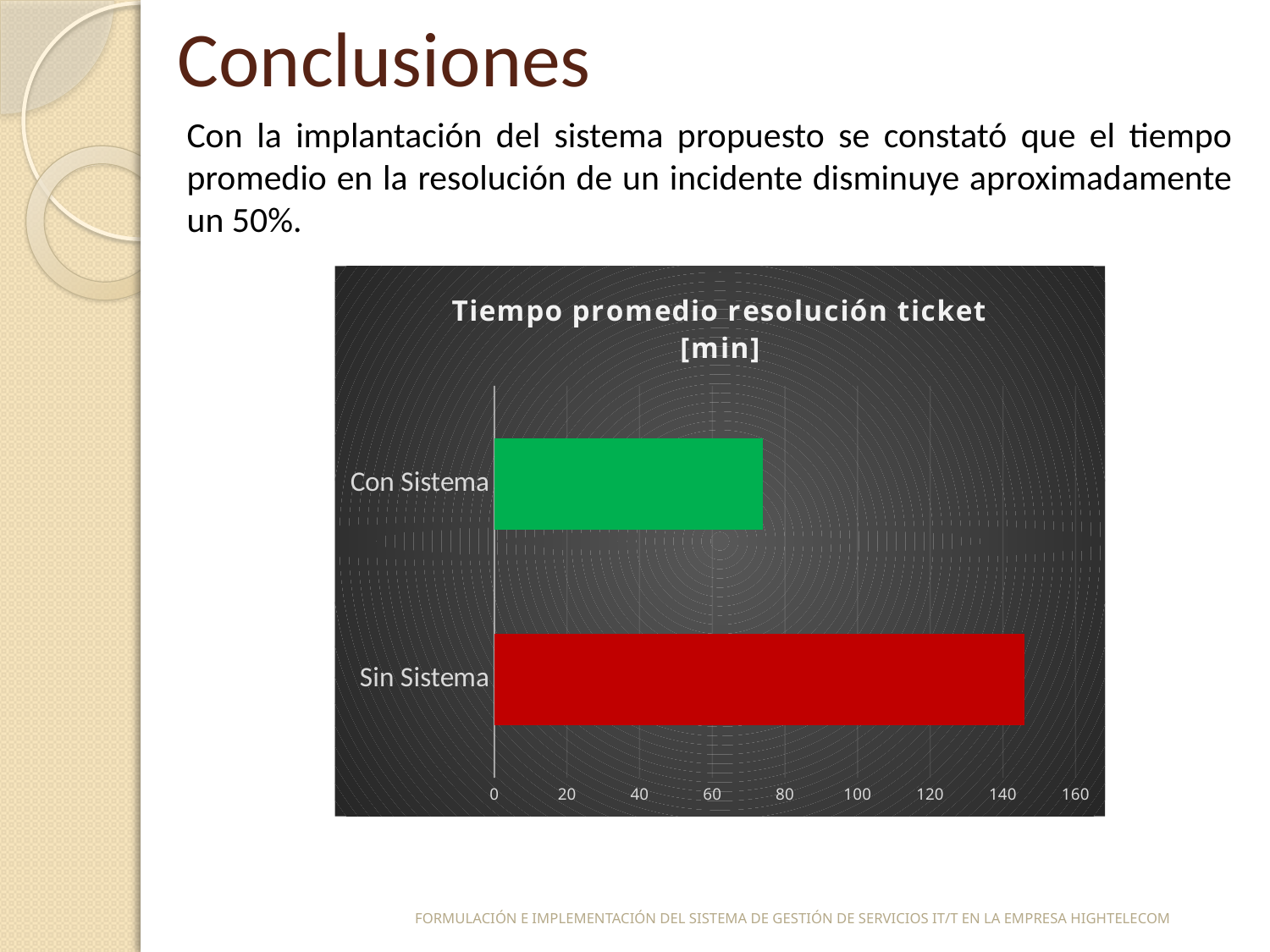
How many categories are plotted in the chart? 2 Is the value for Sin Sistema greater or less than 140? greater Is the value for Con Sistema greater or less than 60? greater Which category has the highest value? Sin Sistema What kind of chart is shown on the slide? bar chart Which is larger, the value for Con Sistema or the value for Sin Sistema? Sin Sistema What is the title of the chart? Tiempo promedio resolución ticket [min] What is the highest value shown on the horizontal axis? 160 Is the value for Sin Sistema greater or less than 160? less What colour is the bar for Sin Sistema? red Which category has the lowest value? Con Sistema